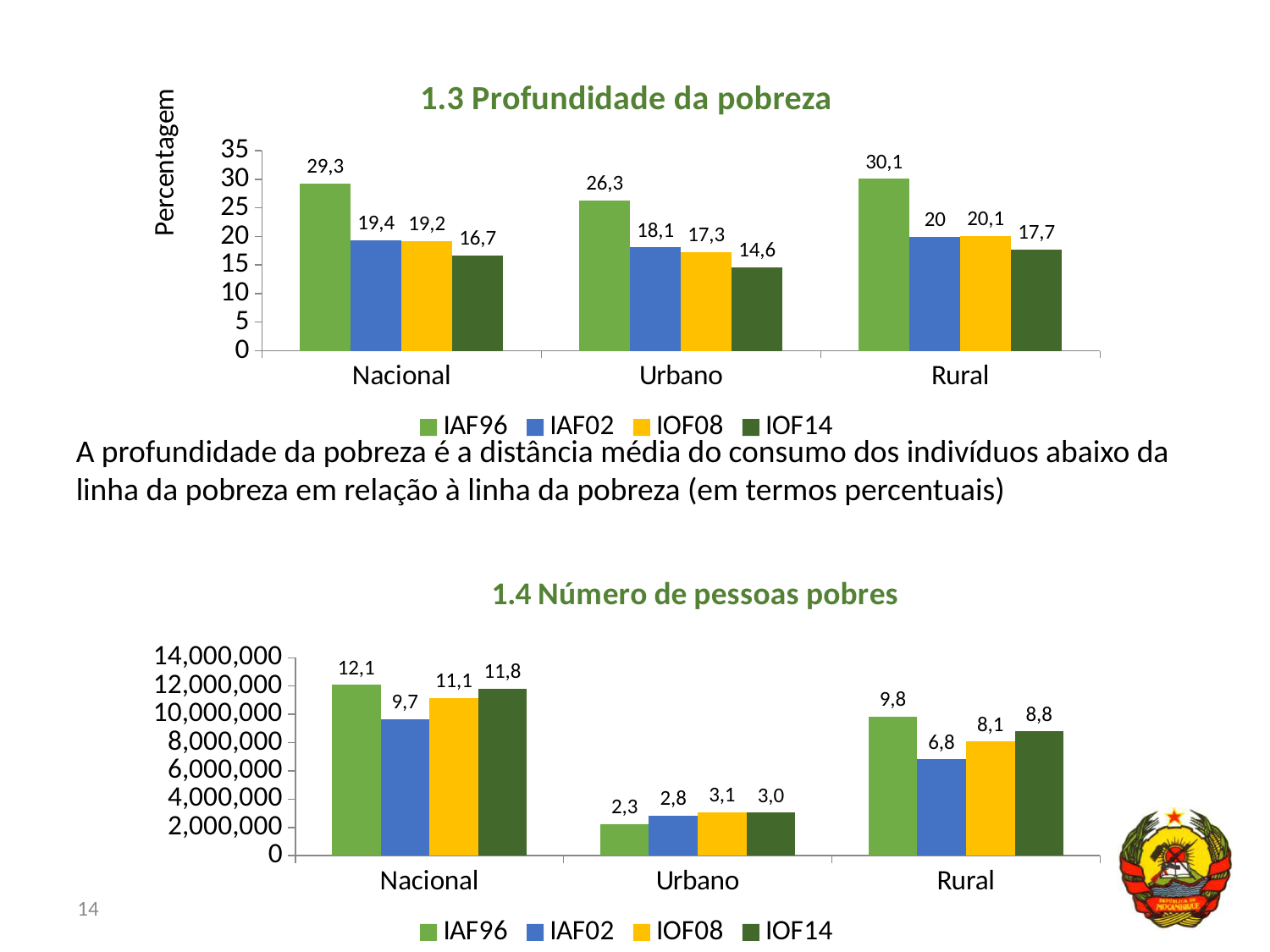
What type of chart is '1.4 Número de pessoas pobres'? Bar chart How many categories are shown on the x axis of the chart '1.4 Número de pessoas pobres'? 3 In the chart '1.3 Profundidade da pobreza', what is the value for IOF14 in the Urbano category? 14,6 In the chart '1.3 Profundidade da pobreza', what is the difference between the IAF96 and IOF14 values for Nacional? 12,6 In the chart '1.4 Número de pessoas pobres', which series has the lowest value in the Urbano category? IAF96 In the chart '1.3 Profundidade da pobreza', which series has the highest value in the Rural category? IAF96 In the chart '1.4 Número de pessoas pobres', is the IAF96 bar for Nacional greater or less than 10,000,000? greater In the chart '1.3 Profundidade da pobreza', what is the value for IAF96 in the Nacional category? 29,3 In the chart '1.4 Número de pessoas pobres', what is the data label for IAF02 in the Rural category? 6,8 What is the y-axis label of the chart '1.3 Profundidade da pobreza'? Percentagem How many series does the legend of the chart '1.3 Profundidade da pobreza' list? 4 In the chart '1.3 Profundidade da pobreza', which is larger for Rural: IAF02 or IOF08? IOF08